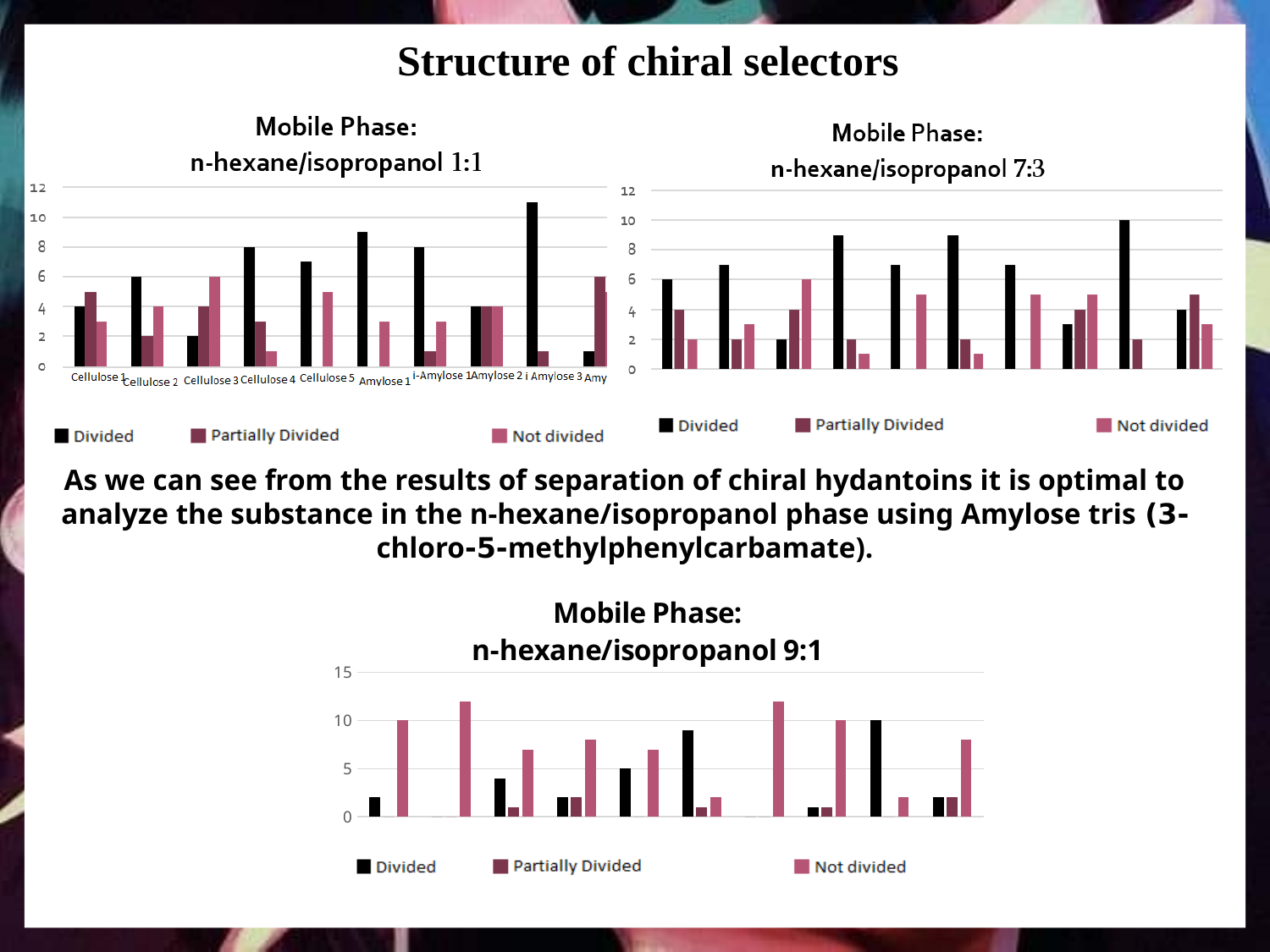
What are the three legend entries of the 'Mobile Phase: n-hexane/isopropanol 9:1' chart? Divided, Partially Divided, Not divided In the 'Mobile Phase: n-hexane/isopropanol 1:1' chart, what is the Not divided value for Cellulose 3? 6 In the 'Mobile Phase: n-hexane/isopropanol 1:1' chart, which is larger, the Divided value for Cellulose 4 or the Divided value for Cellulose 3? Cellulose 4 What kind of chart is the 'Mobile Phase: n-hexane/isopropanol 1:1' chart? bar chart How many series does the legend of the 'Mobile Phase: n-hexane/isopropanol 7:3' chart list? 3 In the 'Mobile Phase: n-hexane/isopropanol 1:1' chart, is the Divided value for i Amylose 3 greater or less than 10? greater What is the highest value shown on the vertical axis of the 'Mobile Phase: n-hexane/isopropanol 9:1' chart? 15 In the 'Mobile Phase: n-hexane/isopropanol 1:1' chart, is the Divided value for Amylose 1 greater or less than 8? greater In the 'Mobile Phase: n-hexane/isopropanol 1:1' chart, which category has the highest Divided bar? i Amylose 3 In the 'Mobile Phase: n-hexane/isopropanol 1:1' chart, what is the difference between the Divided values for Cellulose 4 and Cellulose 2? 2 In the 'Mobile Phase: n-hexane/isopropanol 1:1' chart, what is the Divided value for Cellulose 4? 8 In the 'Mobile Phase: n-hexane/isopropanol 1:1' chart, what is the Divided value for Cellulose 2? 6